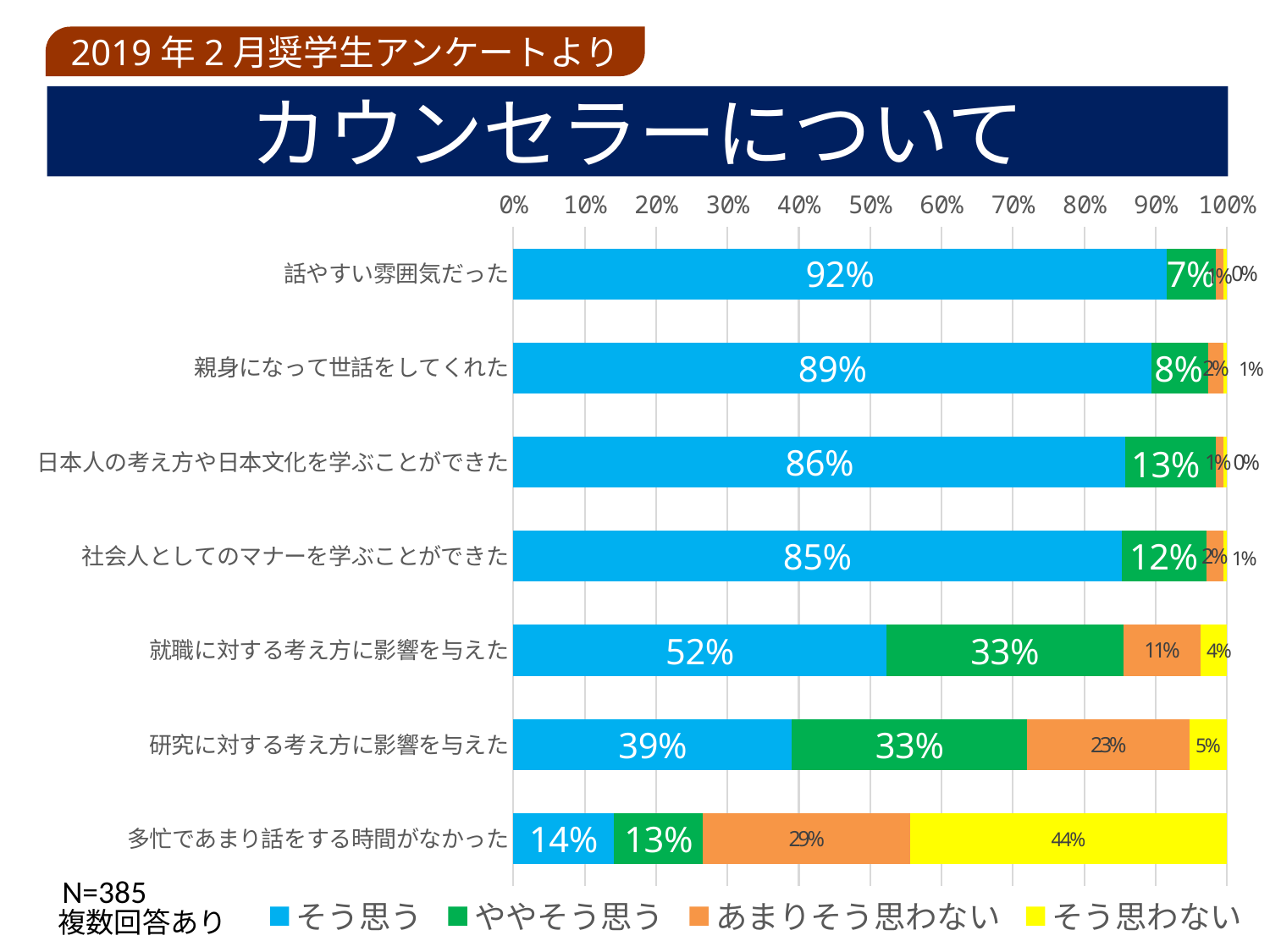
How many series does the legend list? 4 How many categories are shown in the chart? 7 What kind of chart is shown on the slide? Stacked bar chart What is the difference in the そう思う value between 話やすい雰囲気だった and 親身になって世話をしてくれた? 3 percentage points Which category has the highest そう思う value? 話やすい雰囲気だった What is the そう思わない value for 多忙であまり話をする時間がなかった? 44% What is the あまりそう思わない value for 研究に対する考え方に影響を与えた? 23% What percentage of respondents answered そう思う for 話やすい雰囲気だった? 92% Which category has the lowest そう思う value? 多忙であまり話をする時間がなかった Which has a larger ややそう思う value: 日本人の考え方や日本文化を学ぶことができた or 社会人としてのマナーを学ぶことができた? 日本人の考え方や日本文化を学ぶことができた What is the title of the chart on the slide? カウンセラーについて What is the ややそう思う value for 就職に対する考え方に影響を与えた? 33%